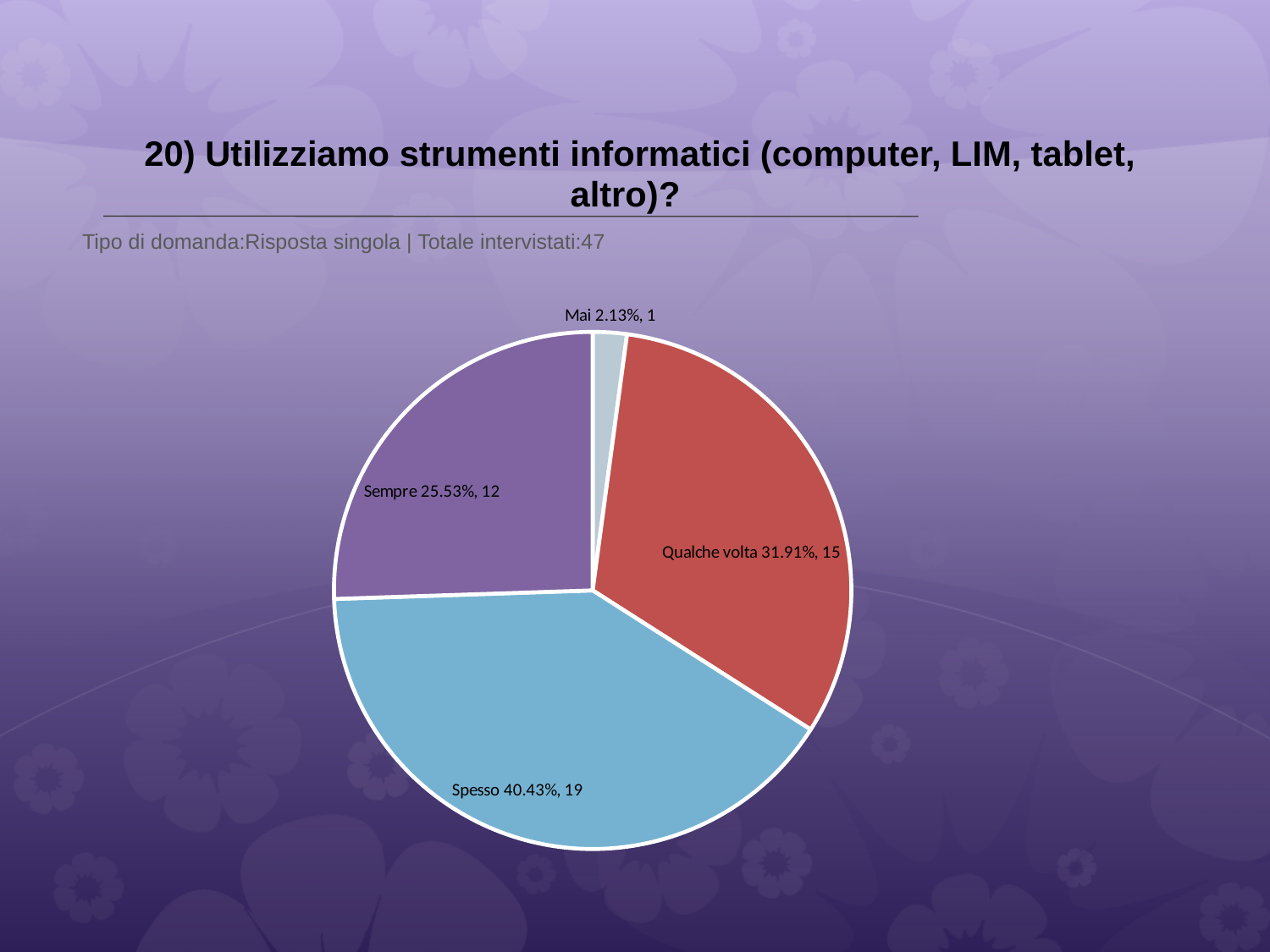
Which has more respondents, 'Sempre' or 'Qualche volta'? Qualche volta What is the difference in respondent count between 'Spesso' and 'Qualche volta'? 4 How many slices does the pie chart have? 4 How many respondents answered 'Sempre'? 12 Which category has the largest slice? Spesso How many respondents answered 'Qualche volta'? 15 What percentage share does the 'Spesso' slice have? 40.43% Which category has the smallest slice? Mai What percentage share does the 'Mai' slice have? 2.13% What kind of chart is shown on the slide? pie chart What colour is the 'Spesso' slice? light blue What is the total number of respondents stated on the slide? 47